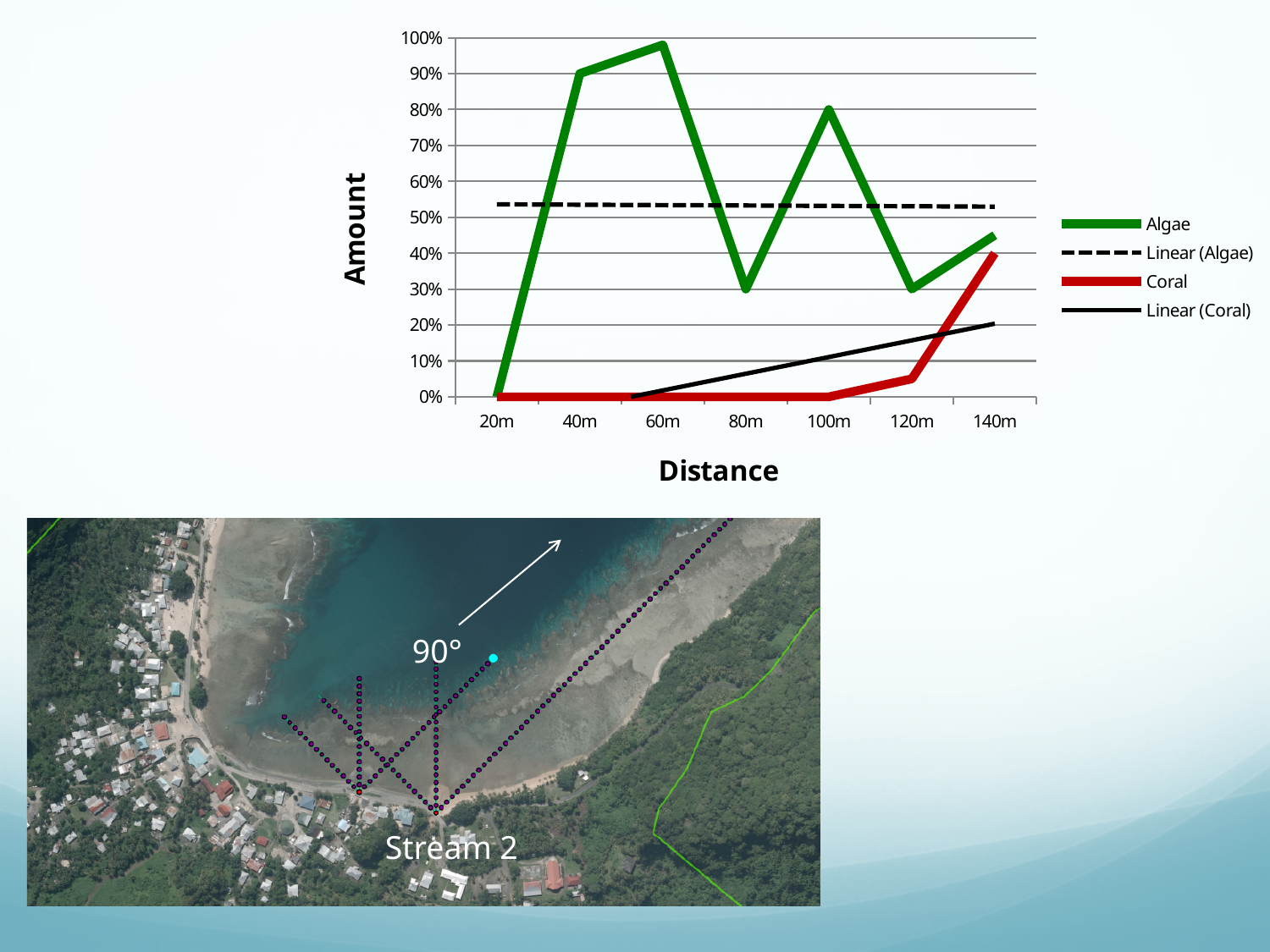
At which distance is the Algae value lowest? 20m What is the title of the x axis of the chart? Distance Is the Algae value at 80m greater or less than 50%? less Which is larger, the Algae value at 100m or the Algae value at 120m? 100m How many entries does the chart legend list? 4 At 120m, which series has the larger value, Algae or Coral? Algae Is the Algae value at 40m greater or less than 80%? greater Is the Coral value at 140m greater or less than 30%? greater At which distance is the Algae value highest? 60m At which distance is the Coral value highest? 140m What kind of chart is shown on the slide? line chart How many distance categories are shown on the x axis of the chart? 7